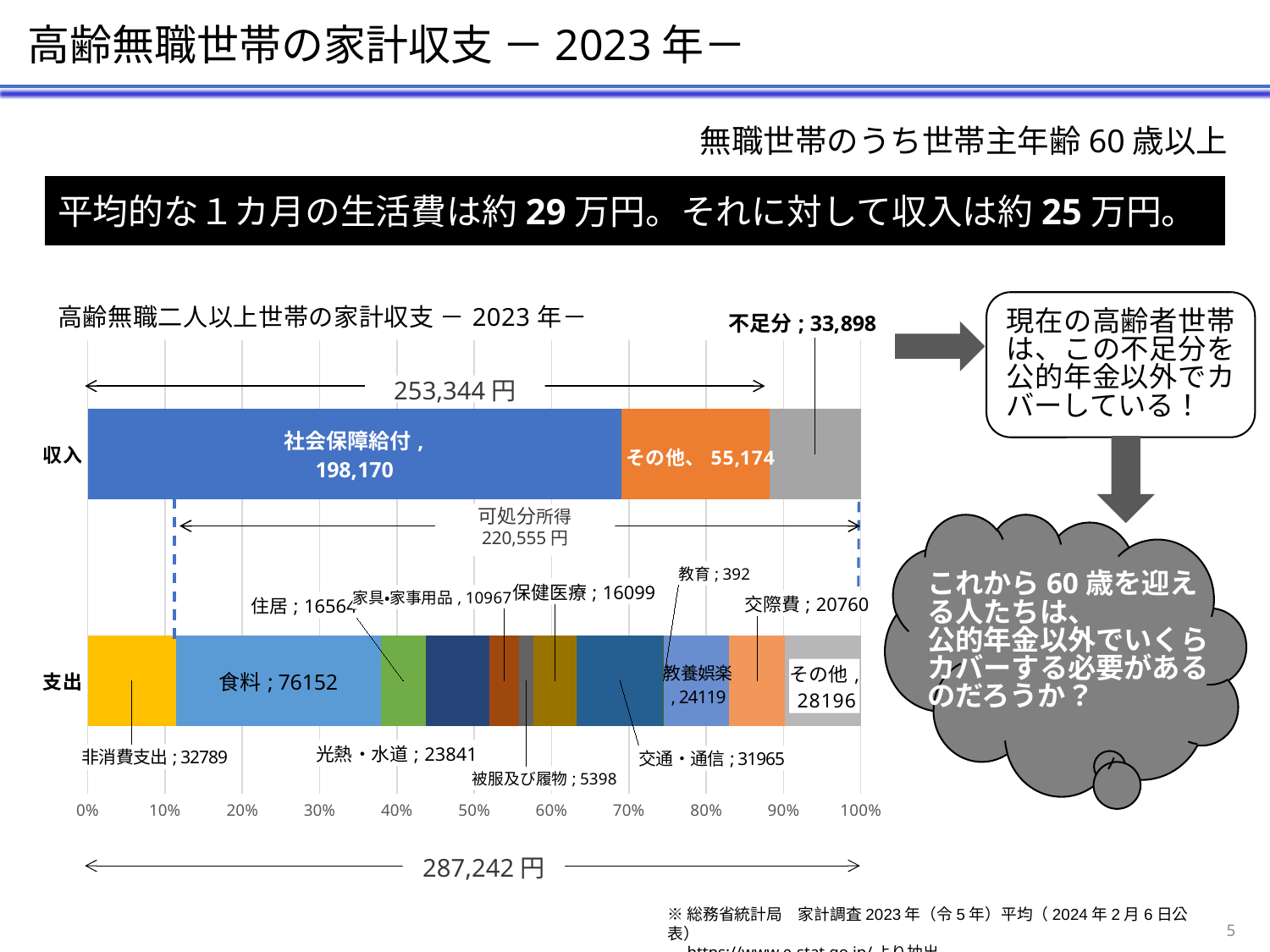
What is the value of 食料 in the 支出 bar? 76152 What kind of chart is shown on the slide? Stacked bar chart Which category in the 支出 bar has the largest value? 食料 Which is larger in the 支出 bar, 住居 or 保健医療? 住居 Which category in the 支出 bar has the smallest value? 教育 What total amount is shown for the 支出 bar? 287,242円 What is the value labelled 不足分? 33,898 What is the value of 交通・通信 in the 支出 bar? 31965 What is the difference between 食料 and 非消費支出 in the 支出 bar? 43363 How many categories make up the 支出 bar? 12 What is the value of その他 in the 収入 bar? 55,174 What is the value of 社会保障給付 in the 収入 bar? 198,170